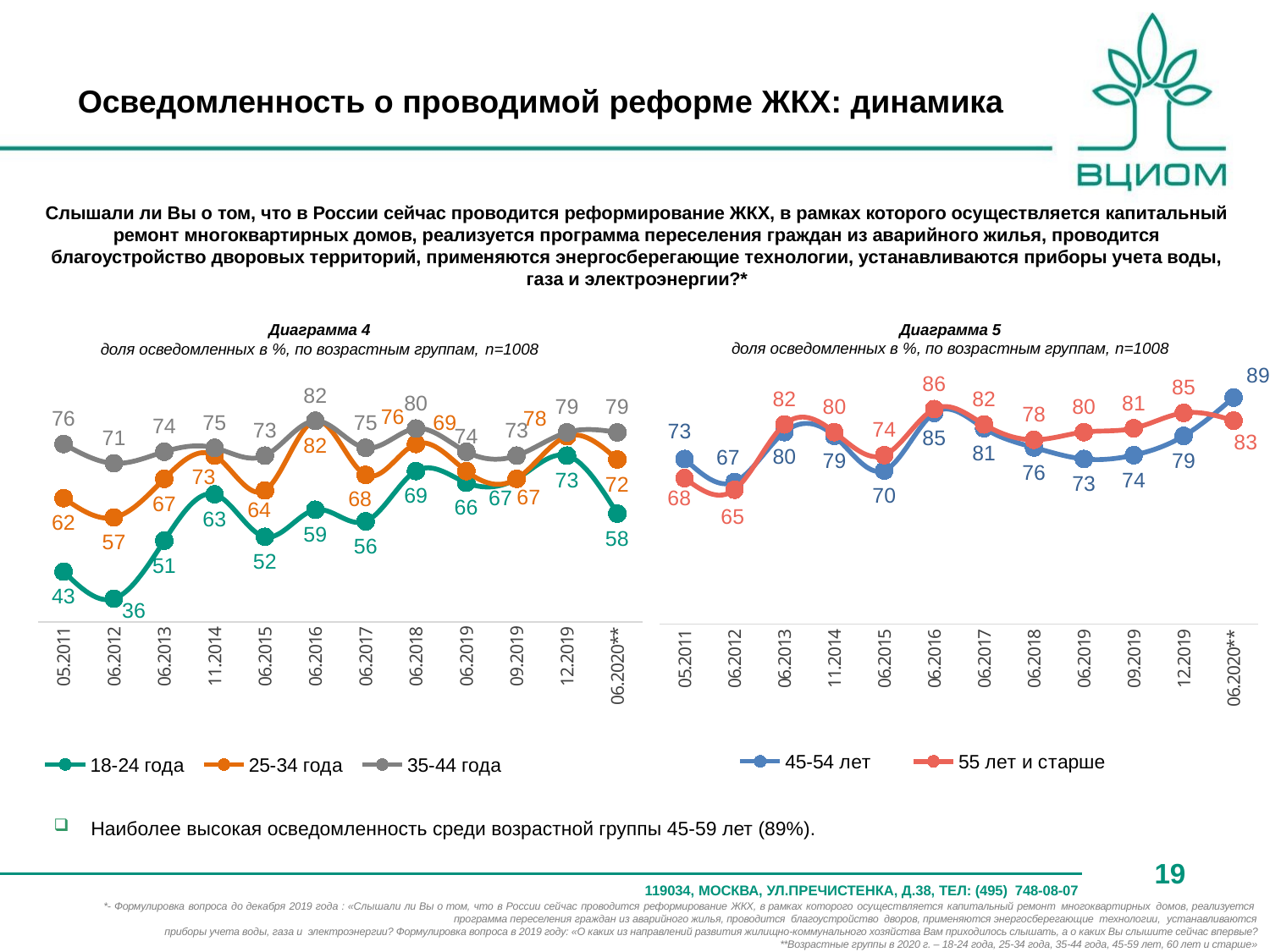
What type of chart is Диаграмма 5? Line chart In Диаграмма 5, what is the difference between the 45-54 лет and 55 лет и старше values at 06.2020**? 6 In Диаграмма 4, at which date is the 18-24 года series lowest? 06.2012 In Диаграмма 5, what is the lowest value of the 55 лет и старше series? 65 How many series does the legend of Диаграмма 4 list? 3 In Диаграмма 5, what is the value for the 45-54 лет series at 06.2020**? 89 In Диаграмма 4, what is the value for the 25-34 года series at 05.2011? 62 In Диаграмма 4, what is the value for the 18-24 года series at 06.2012? 36 How many dates are shown on the x axis of Диаграмма 4? 12 In Диаграмма 5, at which date does the 55 лет и старше series reach its highest value? 06.2016 How many series does the legend of Диаграмма 5 list? 2 In Диаграмма 4, which series has the higher value at 06.2016: 35-44 года or 18-24 года? 35-44 года